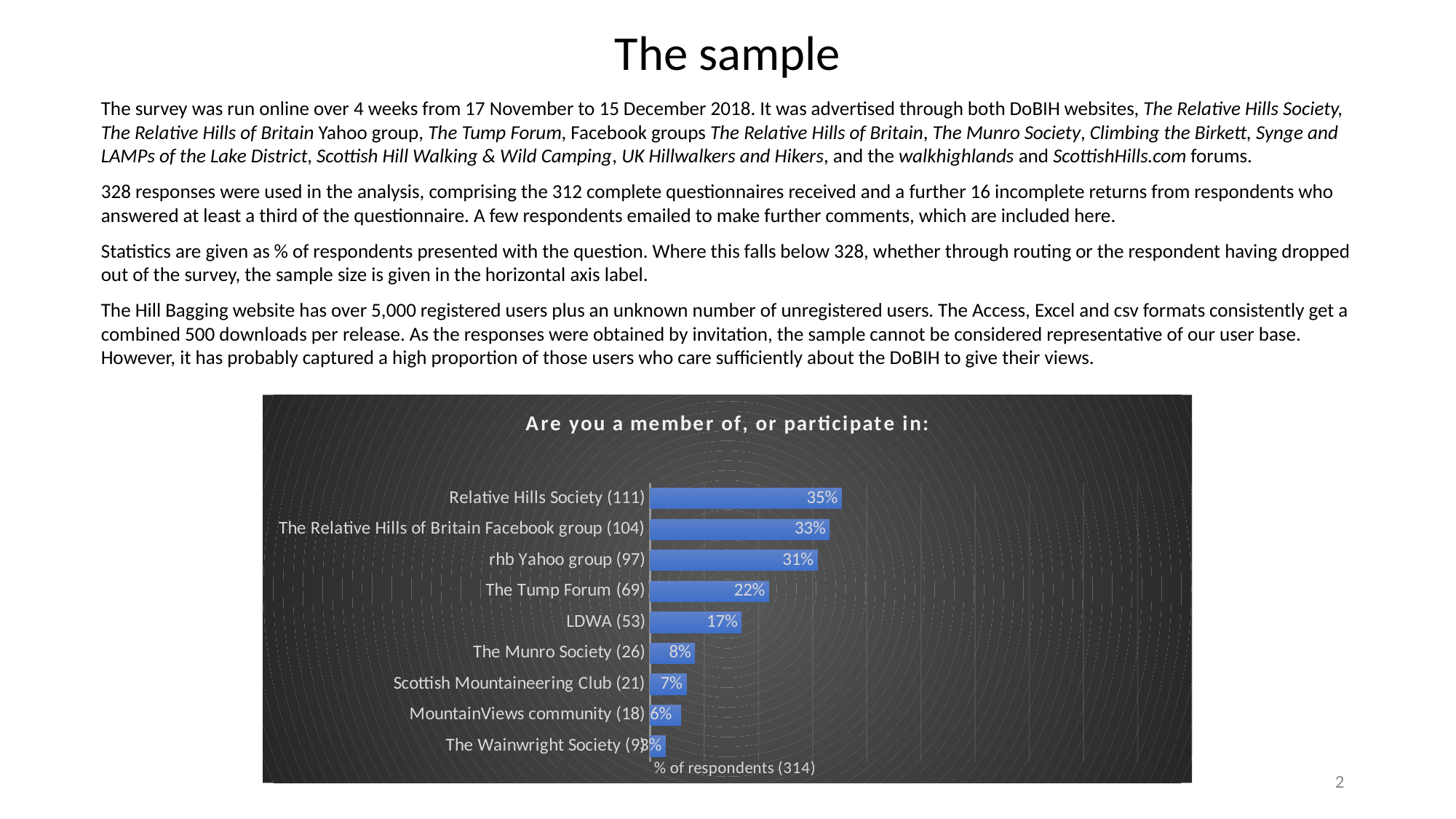
Which is larger, the value for The Munro Society or the value for the Scottish Mountaineering Club? The Munro Society What type of chart is shown on the slide? bar chart How many categories are shown in the chart? 9 What is the value for The Tump Forum? 22% What is the value for the rhb Yahoo group? 31% What percentage of respondents are members of the Relative Hills Society? 35% What is the value for The Relative Hills of Britain Facebook group? 33% What is the title of the chart? Are you a member of, or participate in: Which category has the highest value in the chart? Relative Hills Society (111) What is the horizontal axis label of the chart? % of respondents (314) What is the value for LDWA? 17% What is the difference between the values for The Tump Forum and LDWA? 5%